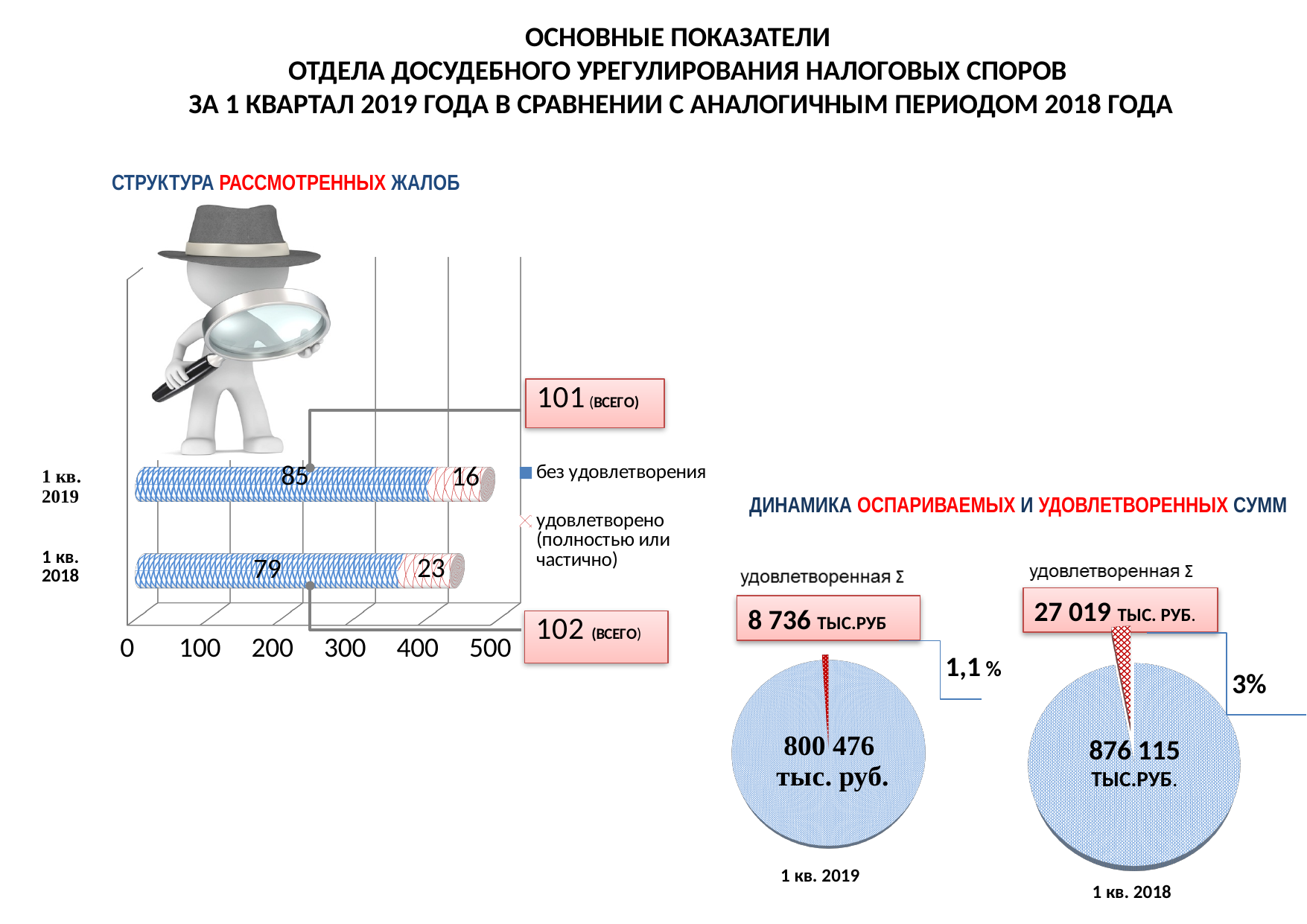
In the chart 'СТРУКТУРА РАССМОТРЕННЫХ ЖАЛОБ', what is the total number of complaints for 1 кв. 2018? 102 What type of chart is 'СТРУКТУРА РАССМОТРЕННЫХ ЖАЛОБ'? Stacked bar chart In the chart 'СТРУКТУРА РАССМОТРЕННЫХ ЖАЛОБ', what is the total number of complaints for 1 кв. 2019? 101 In the chart 'СТРУКТУРА РАССМОТРЕННЫХ ЖАЛОБ', what is the value for 'удовлетворено (полностью или частично)' in 1 кв. 2018? 23 In the pie chart for 1 кв. 2019 under 'ДИНАМИКА ОСПАРИВАЕМЫХ И УДОВЛЕТВОРЕННЫХ СУММ', what is the total disputed sum shown in the centre of the pie? 800 476 тыс. руб. In the chart 'СТРУКТУРА РАССМОТРЕННЫХ ЖАЛОБ', which period has the larger 'без удовлетворения' value, 1 кв. 2019 or 1 кв. 2018? 1 кв. 2019 In the chart 'СТРУКТУРА РАССМОТРЕННЫХ ЖАЛОБ', how many periods (categories) are shown? 2 In the chart 'СТРУКТУРА РАССМОТРЕННЫХ ЖАЛОБ', what is the difference between the 'удовлетворено' values for 1 кв. 2018 and 1 кв. 2019? 7 In the pie chart for 1 кв. 2018 under 'ДИНАМИКА ОСПАРИВАЕМЫХ И УДОВЛЕТВОРЕННЫХ СУММ', what share of the total does the satisfied sum represent? 3% In the chart 'СТРУКТУРА РАССМОТРЕННЫХ ЖАЛОБ', how many series does the legend list? 2 In the chart 'СТРУКТУРА РАССМОТРЕННЫХ ЖАЛОБ', what is the value for 'без удовлетворения' in 1 кв. 2019? 85 In the pie chart for 1 кв. 2019 under 'ДИНАМИКА ОСПАРИВАЕМЫХ И УДОВЛЕТВОРЕННЫХ СУММ', what is the satisfied sum (удовлетворенная Σ)? 8 736 тыс.руб